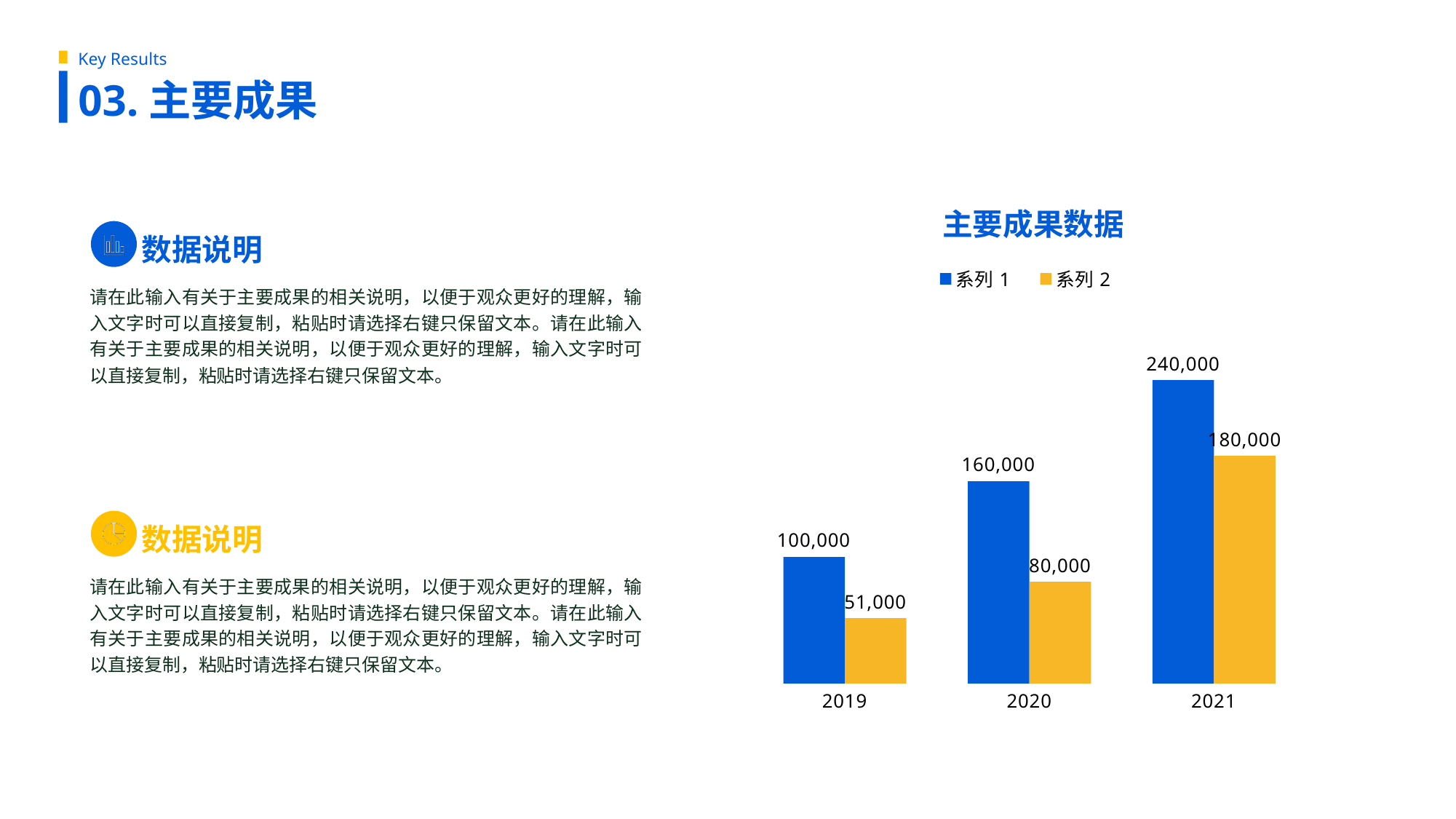
What is the value for 系列 2 in 2019? 51,000 What kind of chart is shown on the slide? bar chart How many years are shown on the x axis? 3 What is the value for 系列 2 in 2021? 180,000 What is the difference between 系列 1 and 系列 2 in 2020? 80,000 How many series does the legend list? 2 What is the value for 系列 1 in 2019? 100,000 Which is larger in 2021, 系列 1 or 系列 2? 系列 1 What is the difference between the 系列 1 values for 2021 and 2019? 140,000 Which year has the highest value for 系列 1? 2021 Do the 系列 2 values rise or fall from 2019 to 2021? rise Which year has the lowest value for 系列 2? 2019